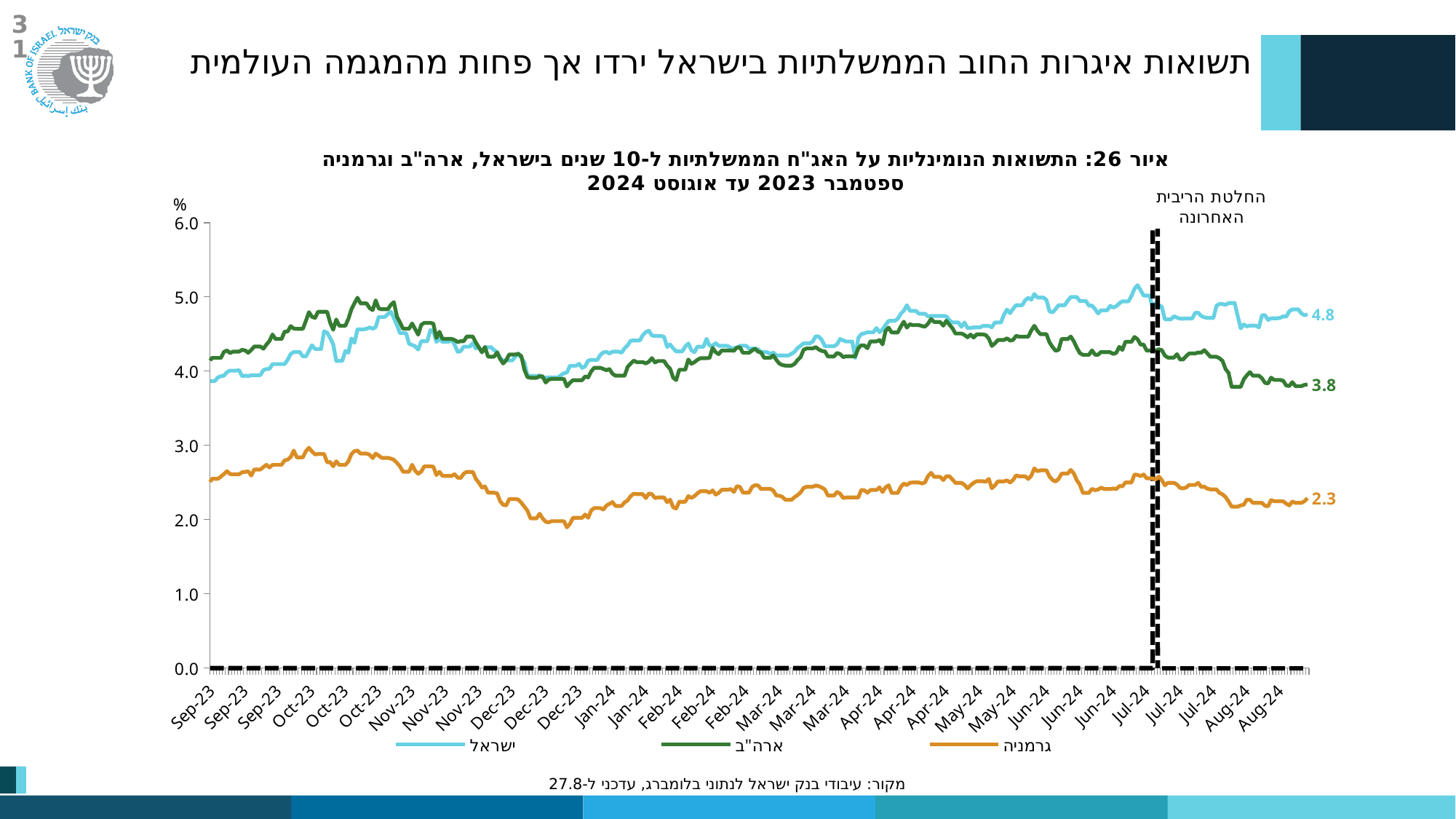
What is the difference between the end-of-period values of ישראל and ארה"ב? 1.0 Does the גרמניה line end higher or lower in Aug-24 than it started in Sep-23? lower Is the value for גרמניה in Dec-23 greater or less than 2.5? less What is the latest value labelled for ארה"ב at the right end of the chart? 3.8 What colour is the line for ארה"ב? green What is the latest value labelled for ישראל at the right end of the chart? 4.8 How many series does the legend list? 3 What is the latest value labelled for גרמניה at the right end of the chart? 2.3 What is the difference between the end-of-period values of ארה"ב and גרמניה? 1.5 Which series has the lowest value at the end of the period (Aug-24)? גרמניה What type of chart is shown on the slide? line chart Which series has the highest value at the end of the period (Aug-24)? ישראל